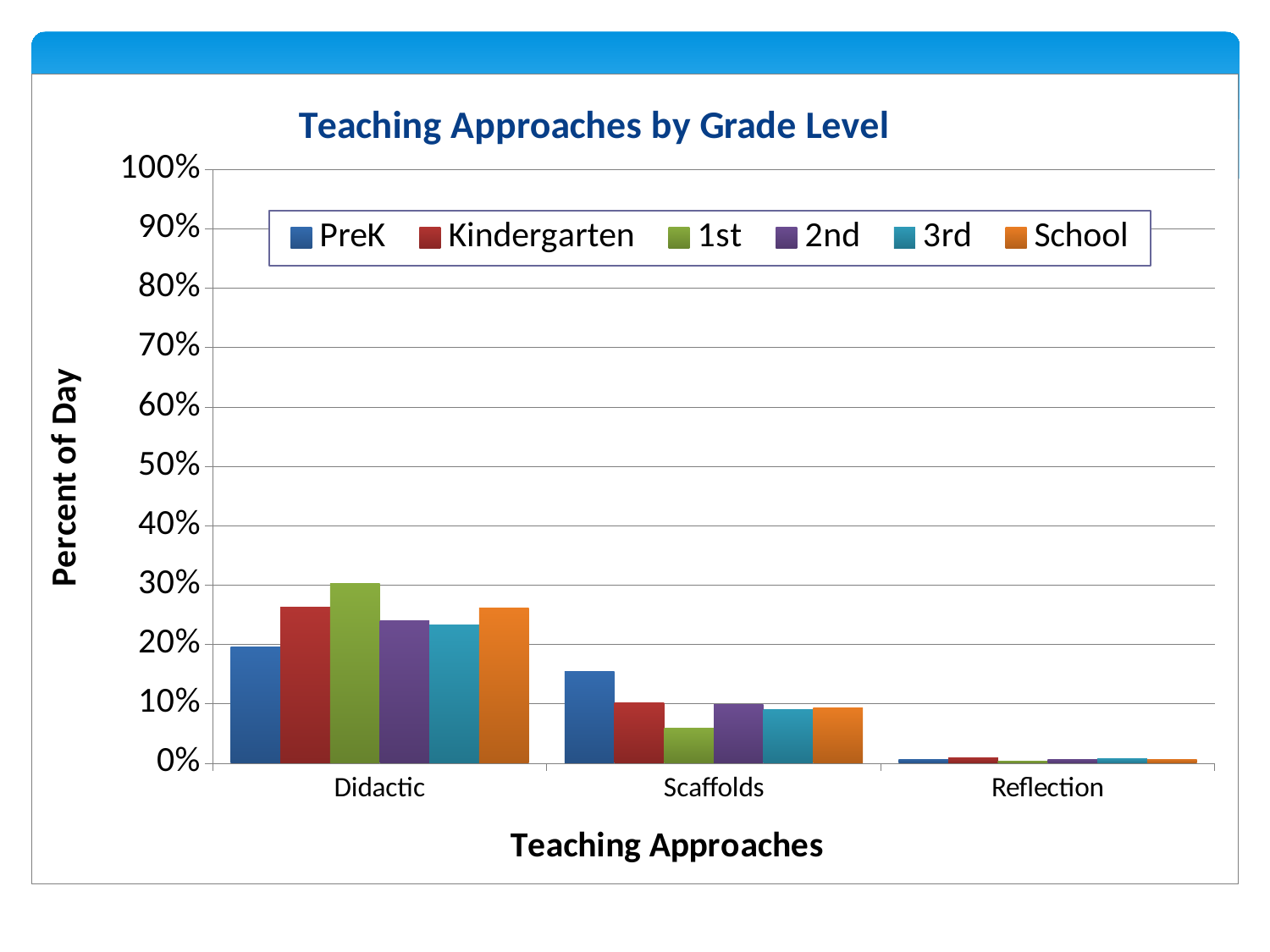
For PreK, which is larger: the Didactic value or the Scaffolds value? Didactic How many teaching approach categories are shown on the x axis? 3 Is the PreK value for Scaffolds greater or less than 10%? greater What is the title of the chart? Teaching Approaches by Grade Level Within the Scaffolds category, which grade level has the highest value? PreK Is the Kindergarten value for Didactic greater or less than 20%? greater Within the Scaffolds category, which grade level has the lowest value? 1st What kind of chart is shown on the slide? bar chart Across the categories from Didactic to Scaffolds to Reflection, do the PreK values rise or fall? fall Within the Didactic category, which grade level has the highest value? 1st Within the Didactic category, which grade level has the lowest value? PreK How many series does the legend list? 6